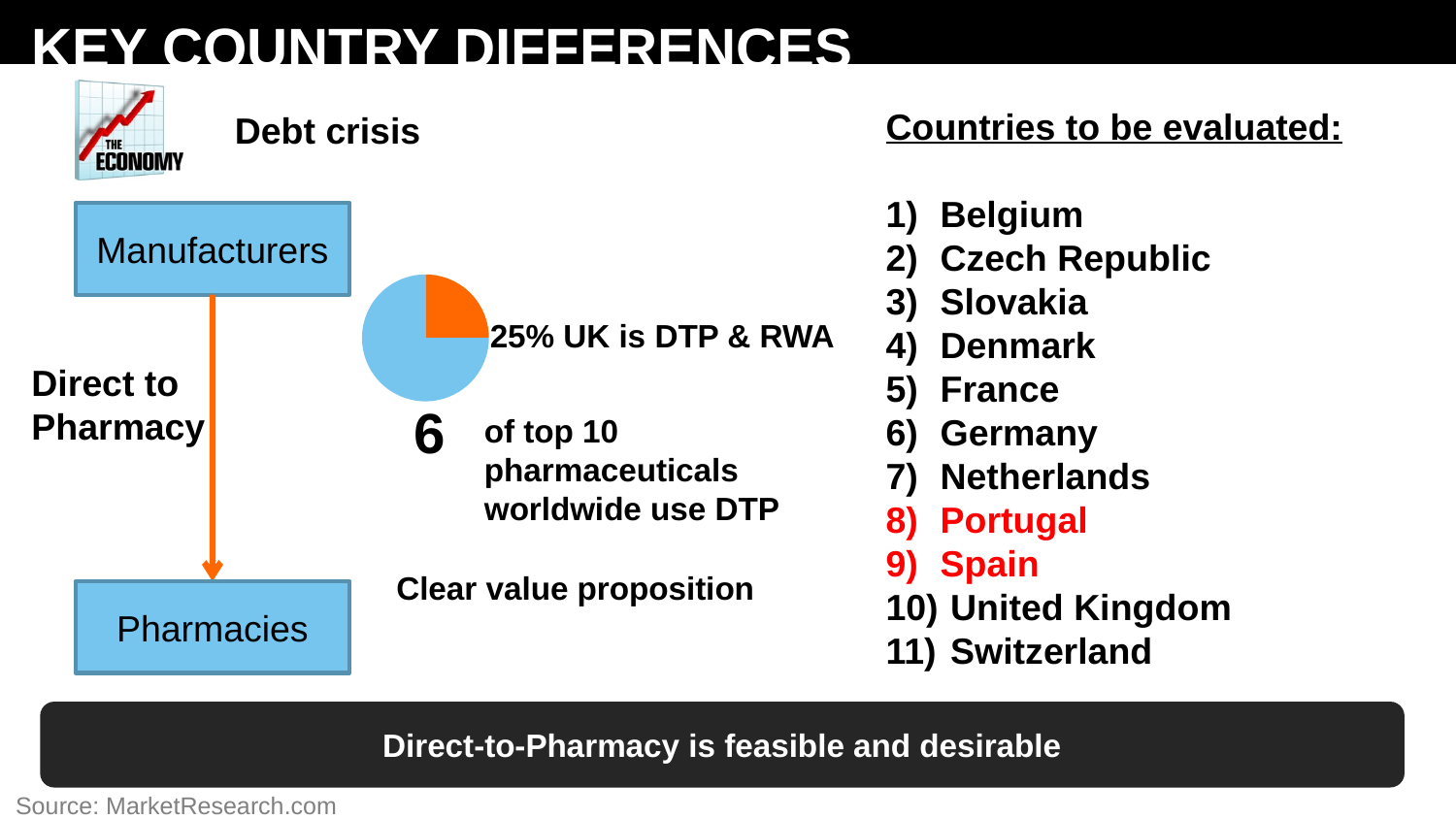
What share of the pie chart does the orange slice represent? 25% Which slice of the pie chart is larger, the orange slice or the blue slice? blue What is the label printed next to the orange slice of the pie chart? 25% UK is DTP & RWA Which slice of the pie chart is the smallest? the orange slice (25% UK is DTP & RWA) What kind of chart is shown on the slide? pie chart How many slices does the pie chart have? 2 What colour is the slice labelled 25% in the pie chart? orange